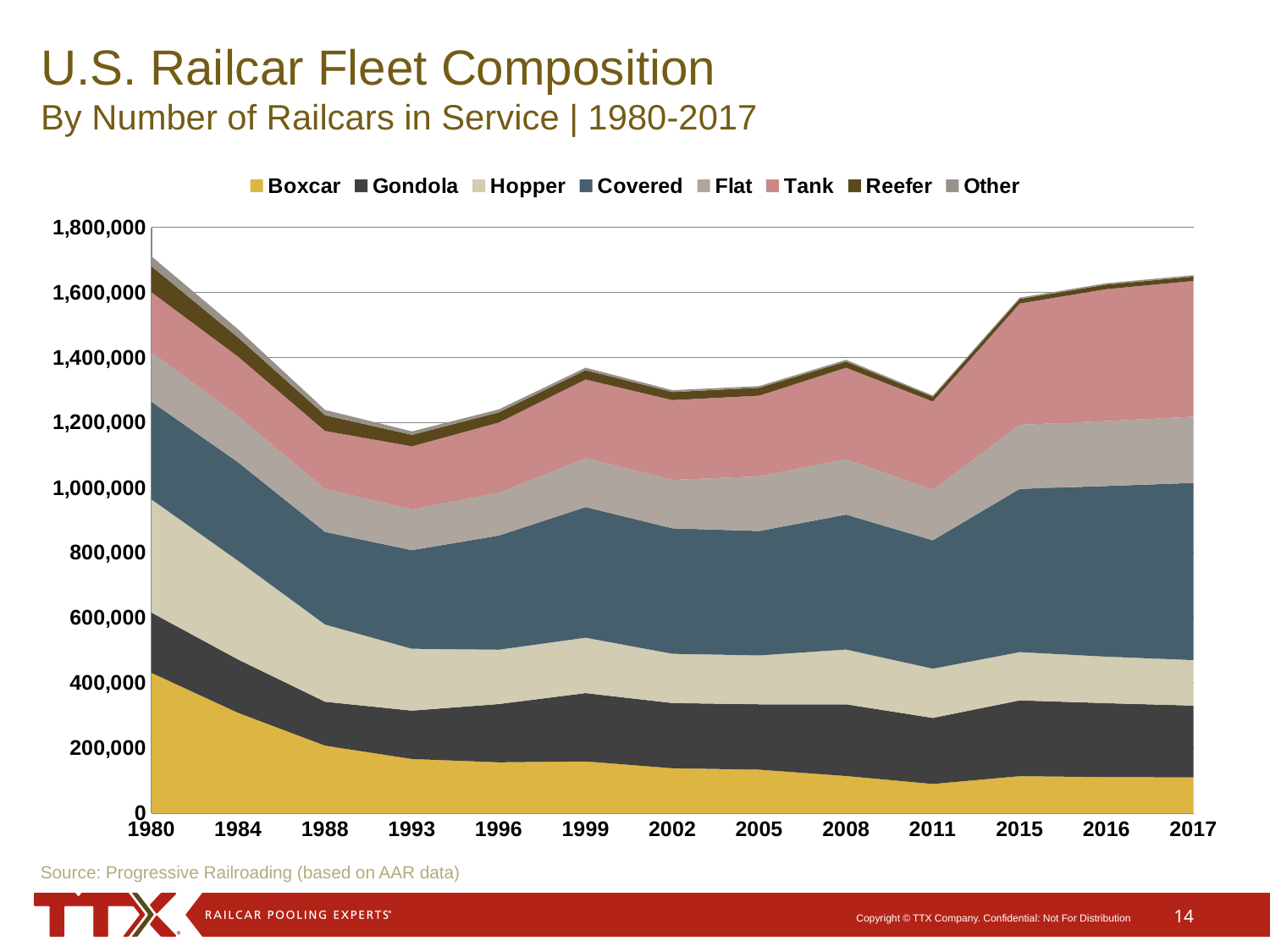
How many series does the legend list? 8 What is the title of the chart? U.S. Railcar Fleet Composition Is the total number of railcars in 1993 greater or less than 1,200,000? less Which year has the lowest total number of railcars in service? 1993 How many years are labelled along the x axis? 13 Is the Boxcar value in 2017 greater or less than 200,000? less Is the total number of railcars in 1980 greater or less than 1,600,000? greater What kind of chart is shown on the slide? Stacked area chart Is the total number of railcars larger in 2011 or in 2017? 2017 Which series is plotted at the bottom of the stack? Boxcar Does the Boxcar series rise or fall from 1980 to 2017? fall